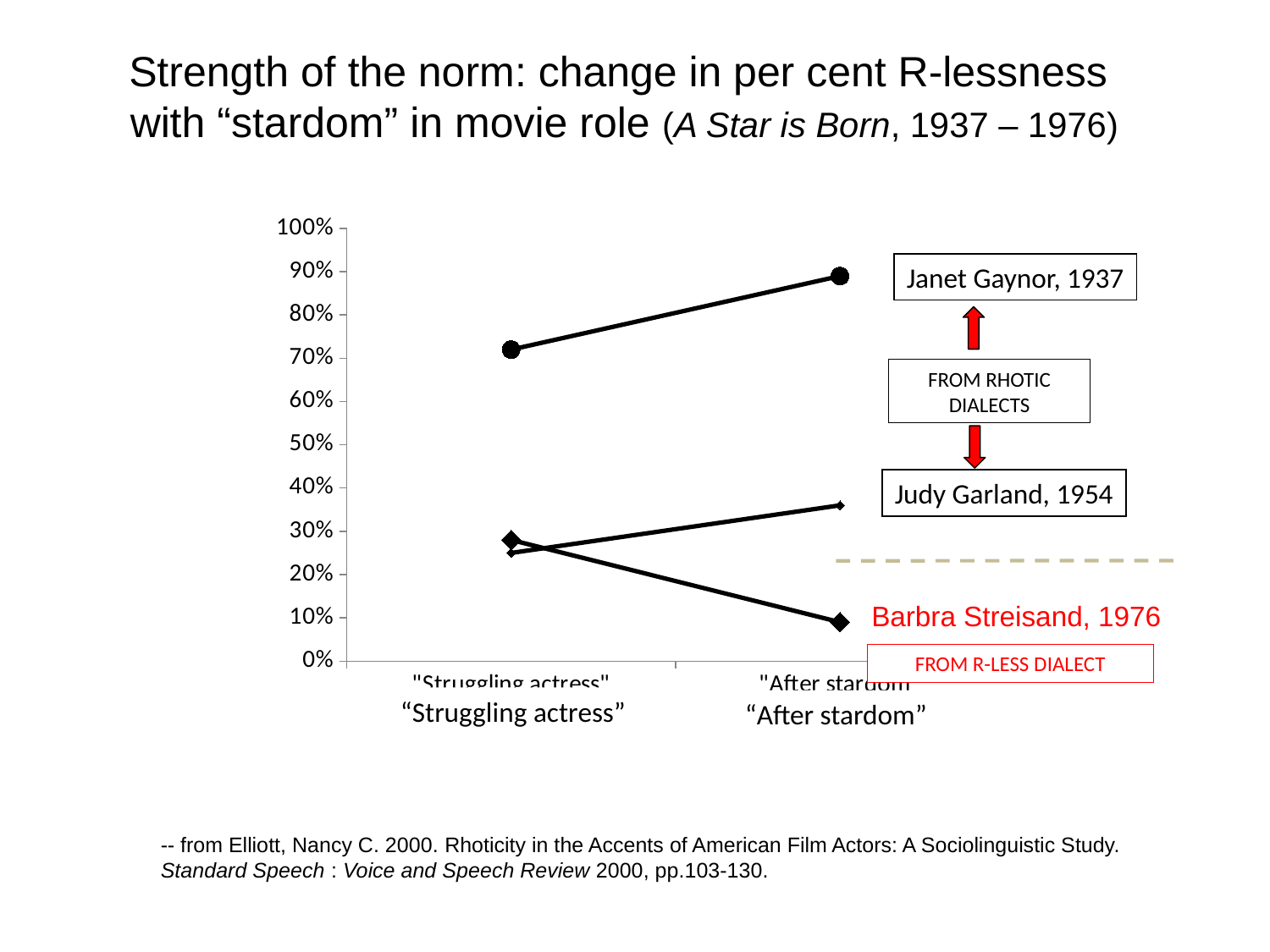
Which actress has the highest per cent R-lessness at "After stardom"? Janet Gaynor, 1937 Which actress is labelled as coming from an R-less dialect? Barbra Streisand, 1976 How many categories are shown on the x axis of the chart? 2 Which actress has the lowest per cent R-lessness at "After stardom"? Barbra Streisand, 1976 Is the value for Judy Garland at "Struggling actress" greater or less than 50%? less Is the value for Barbra Streisand at "After stardom" greater or less than 20%? less How many actresses (lines) are plotted on the chart? 3 Does Janet Gaynor's per cent R-lessness rise or fall from "Struggling actress" to "After stardom"? rise Is the value for Janet Gaynor at "Struggling actress" greater or less than 60%? greater Does Barbra Streisand's per cent R-lessness rise or fall from "Struggling actress" to "After stardom"? fall What kind of chart is shown on the slide? line chart